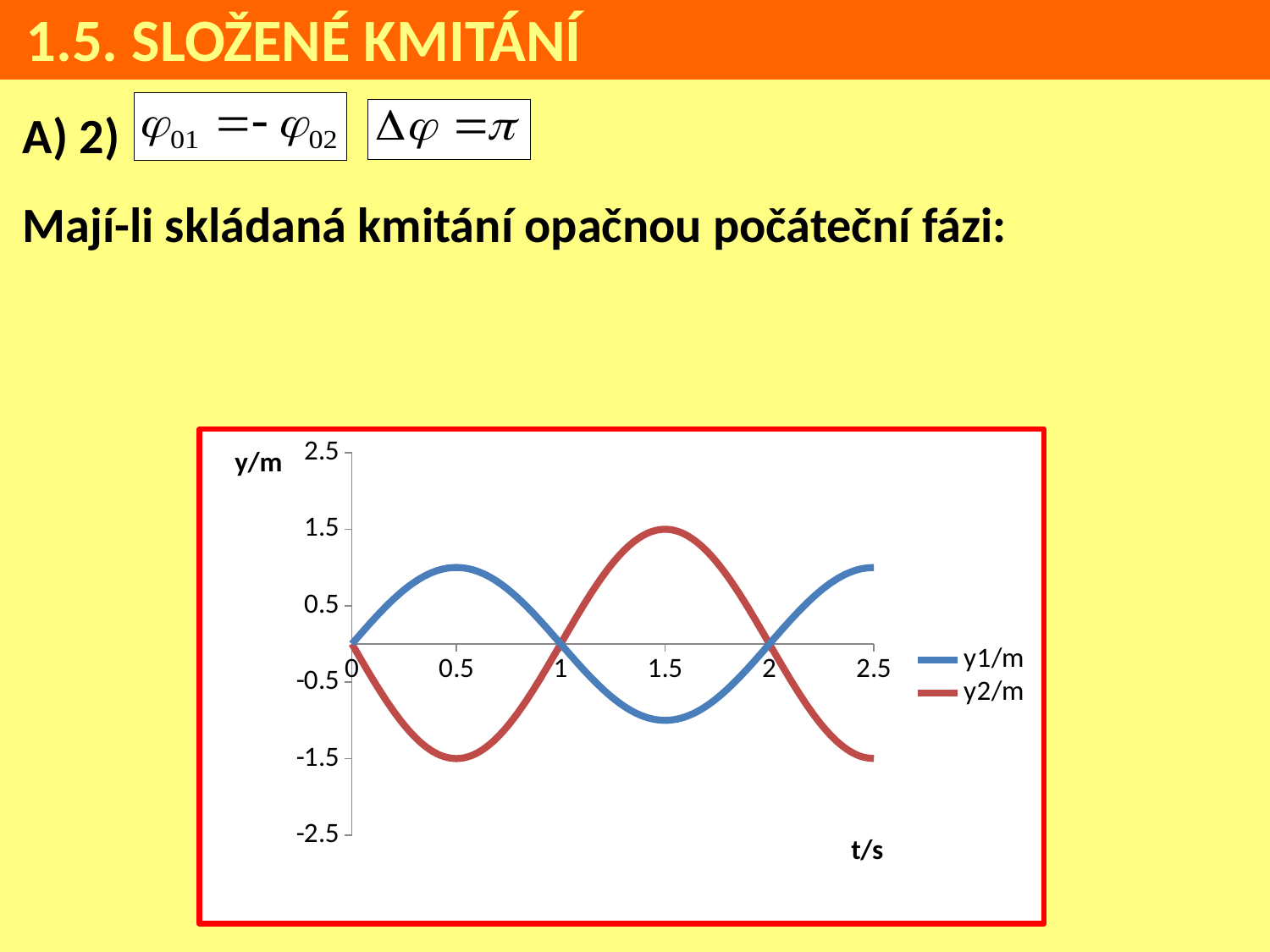
What kind of chart is shown on the slide? line chart What is the label of the horizontal axis of the chart? t/s Is the value of y1/m at t = 0.5 greater or less than 0.5? greater Between t = 0.5 and t = 1.5, does the y1/m series rise or fall? fall What is the value of y2/m at t = 0.5? -1.5 At t = 1.5, which series has the larger value, y1/m or y2/m? y2/m What is the value of y2/m at t = 1.5? 1.5 What are the two series named in the chart legend? y1/m and y2/m Is the value of y1/m at t = 1.5 greater or less than -0.5? less How many series does the chart legend list? 2 Which series reaches the higher maximum value on the chart? y2/m At t = 0.5, which series has the larger value, y1/m or y2/m? y1/m